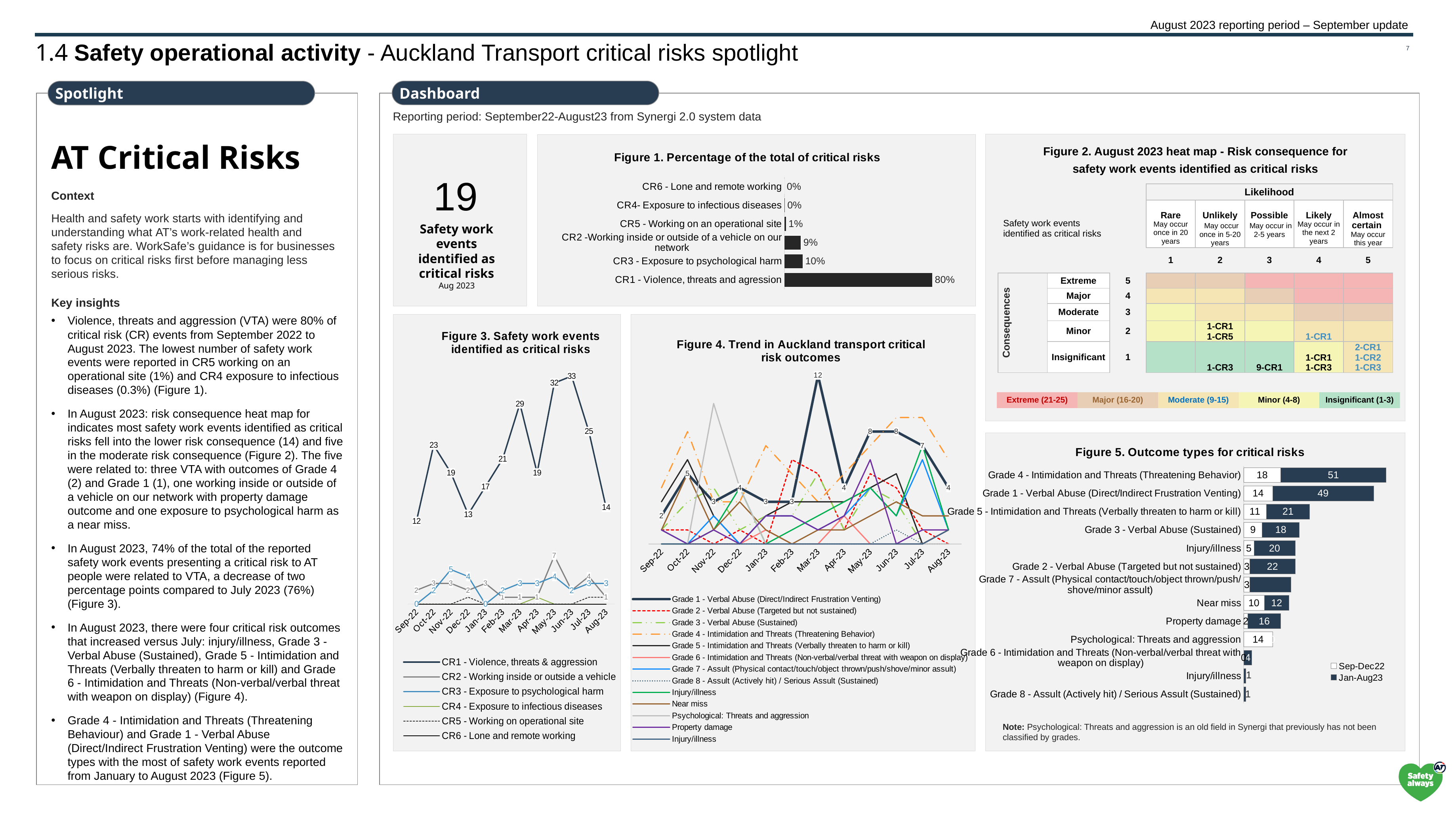
In Figure 1, how many critical risk categories are plotted? 6 In Figure 1, which critical risk has the highest percentage? CR1 - Violence, threats and agression In Figure 1, what percentage is shown for CR3 - Exposure to psychological harm? 10% In Figure 4, what is the value for Grade 1 - Verbal Abuse (Direct/Indirect Frustration Venting) in Mar-23? 12 In Figure 5, what is the Jan-Aug23 value for Grade 4 - Intimidation and Threats (Threatening Behavior)? 51 What kind of chart is Figure 1? Bar chart In Figure 3, what is the value for CR1 - Violence, threats & aggression in Jun-23? 33 In Figure 1, what is the difference in percentage points between CR1 - Violence, threats and agression and CR2 - Working inside or outside of a vehicle on our network? 71 In Figure 3, how many series does the legend list? 6 In Figure 3, in which month is the CR1 - Violence, threats & aggression line lowest? Sep-22 In Figure 5, which is larger for Grade 1 - Verbal Abuse (Direct/Indirect Frustration Venting): the Sep-Dec22 value or the Jan-Aug23 value? Jan-Aug23 In Figure 1, what percentage of the total of critical risks is CR1 - Violence, threats and agression? 80%